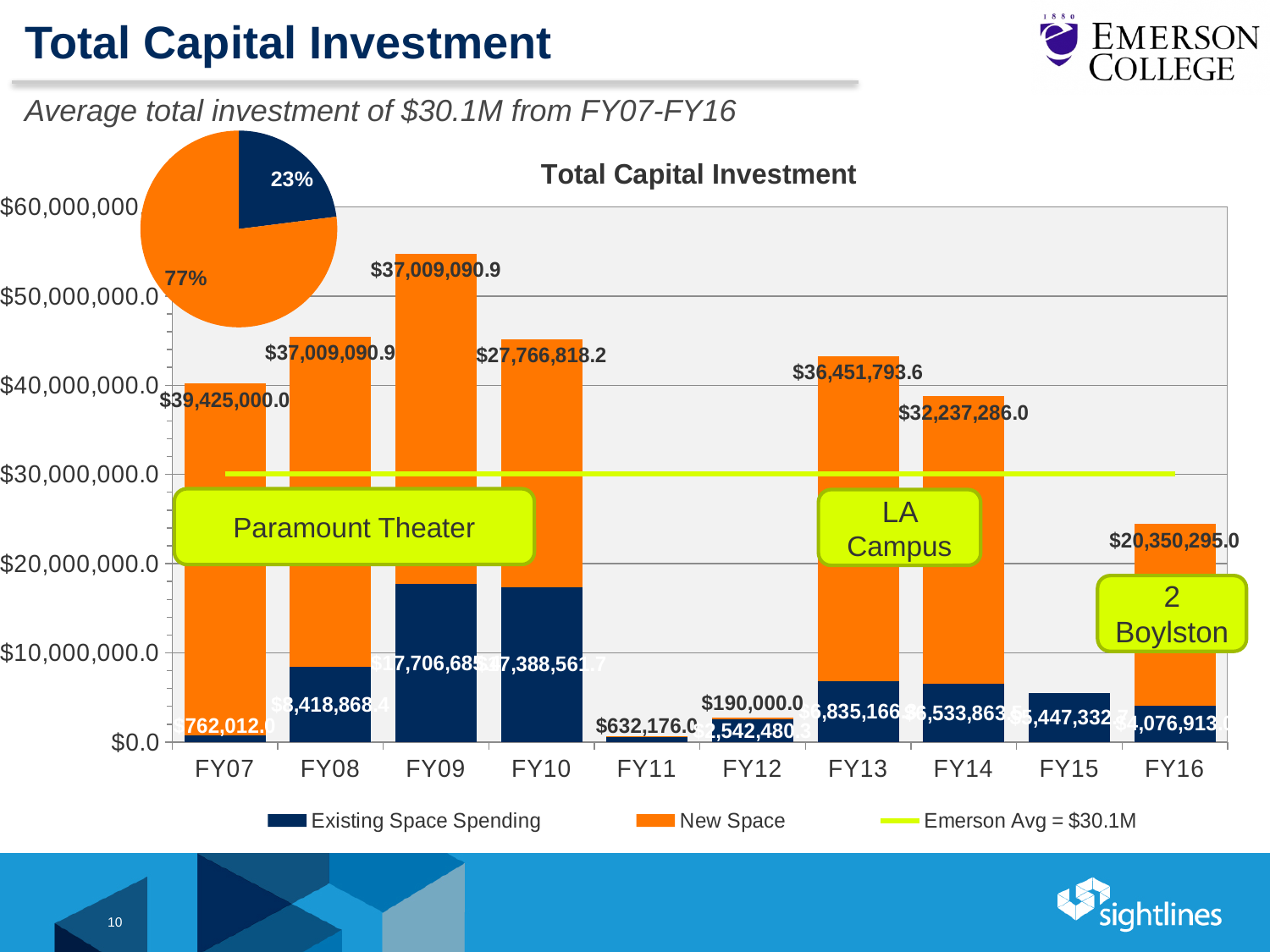
In the Total Capital Investment bar chart, which fiscal year has the lowest total bar? FY11 What is the New Space value for FY12 in the Total Capital Investment bar chart? $190,000.0 In the Total Capital Investment bar chart, is the total value for FY15 greater or less than $10,000,000.0? less In the Total Capital Investment bar chart, what is the difference between the New Space values for FY13 and FY14? $4,214,507.6 How many entries does the legend of the Total Capital Investment bar chart list? 3 In the Total Capital Investment bar chart, is the New Space value larger for FY13 or FY14? FY13 What is the New Space value for FY16 in the Total Capital Investment bar chart? $20,350,295.0 In the Total Capital Investment bar chart, which fiscal year has the highest total bar? FY09 What kind of chart is the Total Capital Investment chart? Stacked bar chart What is the New Space value for FY07 in the Total Capital Investment bar chart? $39,425,000.0 How many fiscal years are shown on the x axis of the Total Capital Investment bar chart? 10 What is the New Space value for FY13 in the Total Capital Investment bar chart? $36,451,793.6